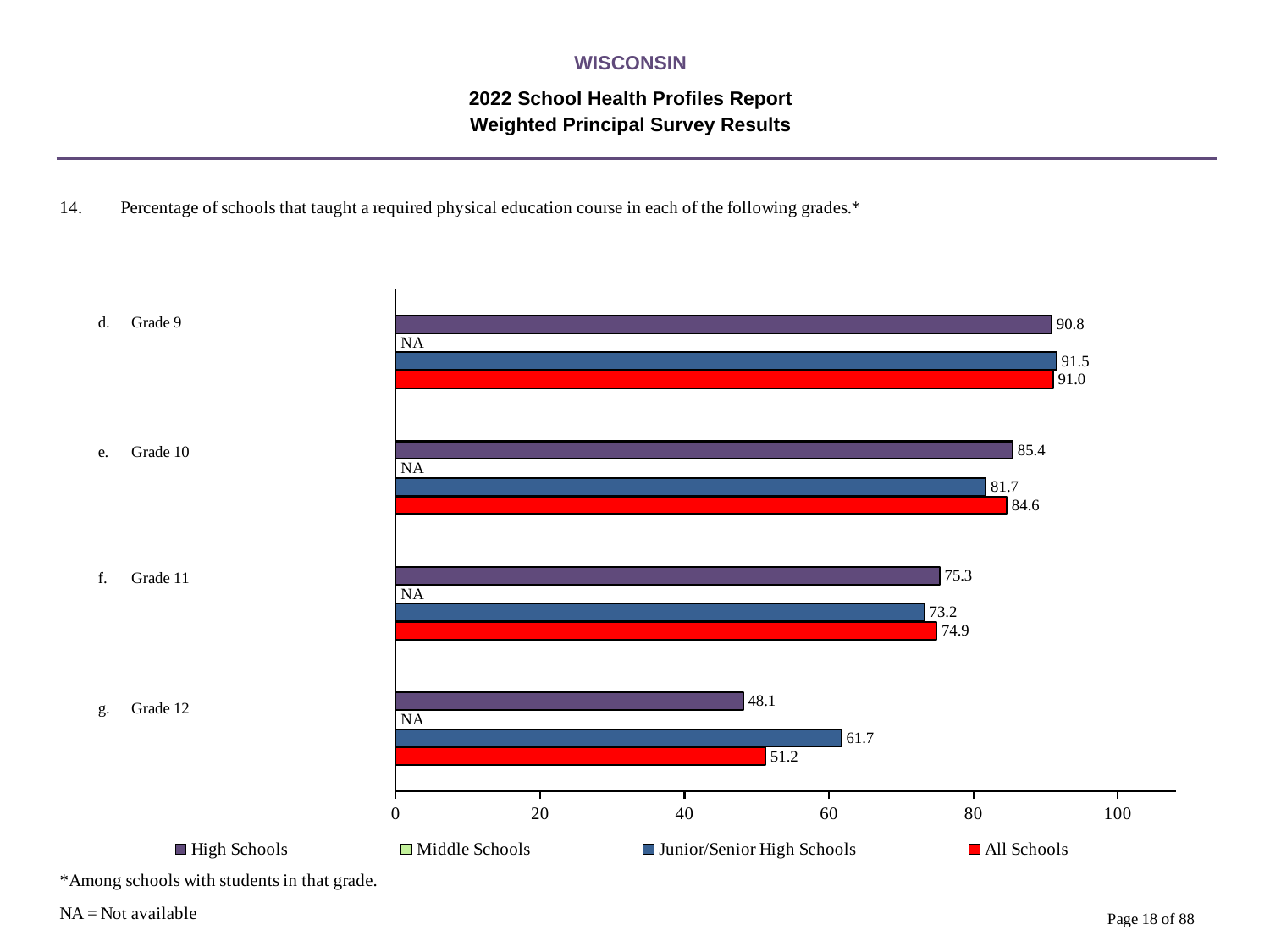
In Grade 10, which is larger: the High Schools value or the Junior/Senior High Schools value? High Schools What is the difference between the Junior/Senior High Schools and High Schools values in Grade 12? 13.6 What is the value for High Schools in Grade 12? 48.1 What is the value for All Schools in Grade 10? 84.6 Do the All Schools values rise or fall from Grade 9 to Grade 12? Fall What is the value for Middle Schools in Grade 11? NA How many grade categories are shown in the chart? 4 Which grade has the lowest value for All Schools? Grade 12 Which grade has the highest value for High Schools? Grade 9 What is the value for Junior/Senior High Schools in Grade 9? 91.5 How many series does the legend list? 4 What kind of chart is shown on the slide? Bar chart